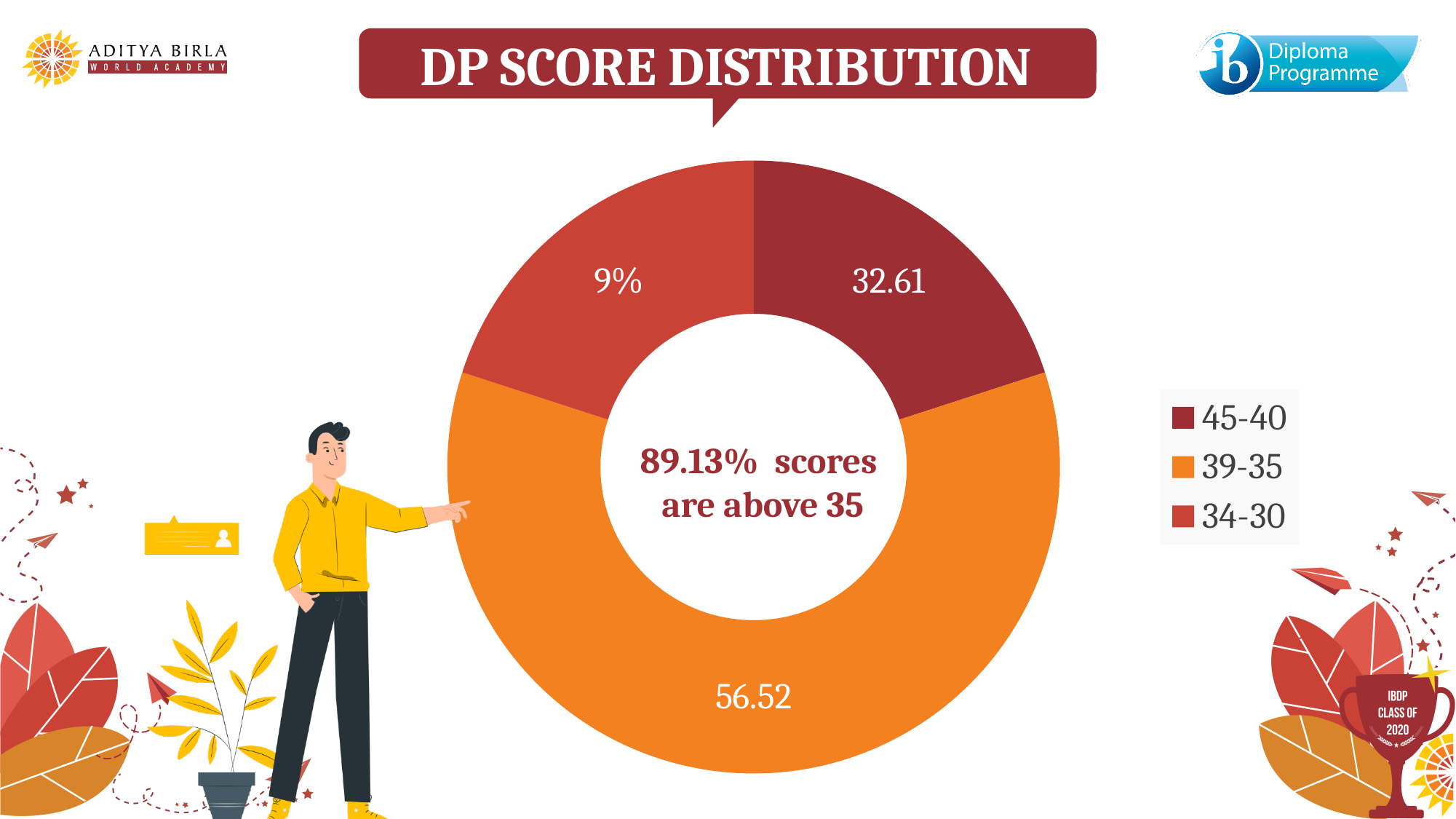
How many entries does the legend list? 3 How many score bands are shown in the chart? 3 Which score band has the smallest share of the chart? 34-30 What kind of chart is shown on the slide? doughnut chart What value is shown for the 34-30 score band? 9% What is the title of the chart? DP SCORE DISTRIBUTION Which score band has the largest share of the chart? 39-35 What value is shown for the 39-35 score band? 56.52 According to the text in the centre of the chart, what percentage of scores are above 35? 89.13% What is the difference between the values for the 39-35 and 45-40 bands? 23.91 What value is shown for the 45-40 score band? 32.61 Which is larger, the value for 45-40 or the value for 34-30? 45-40